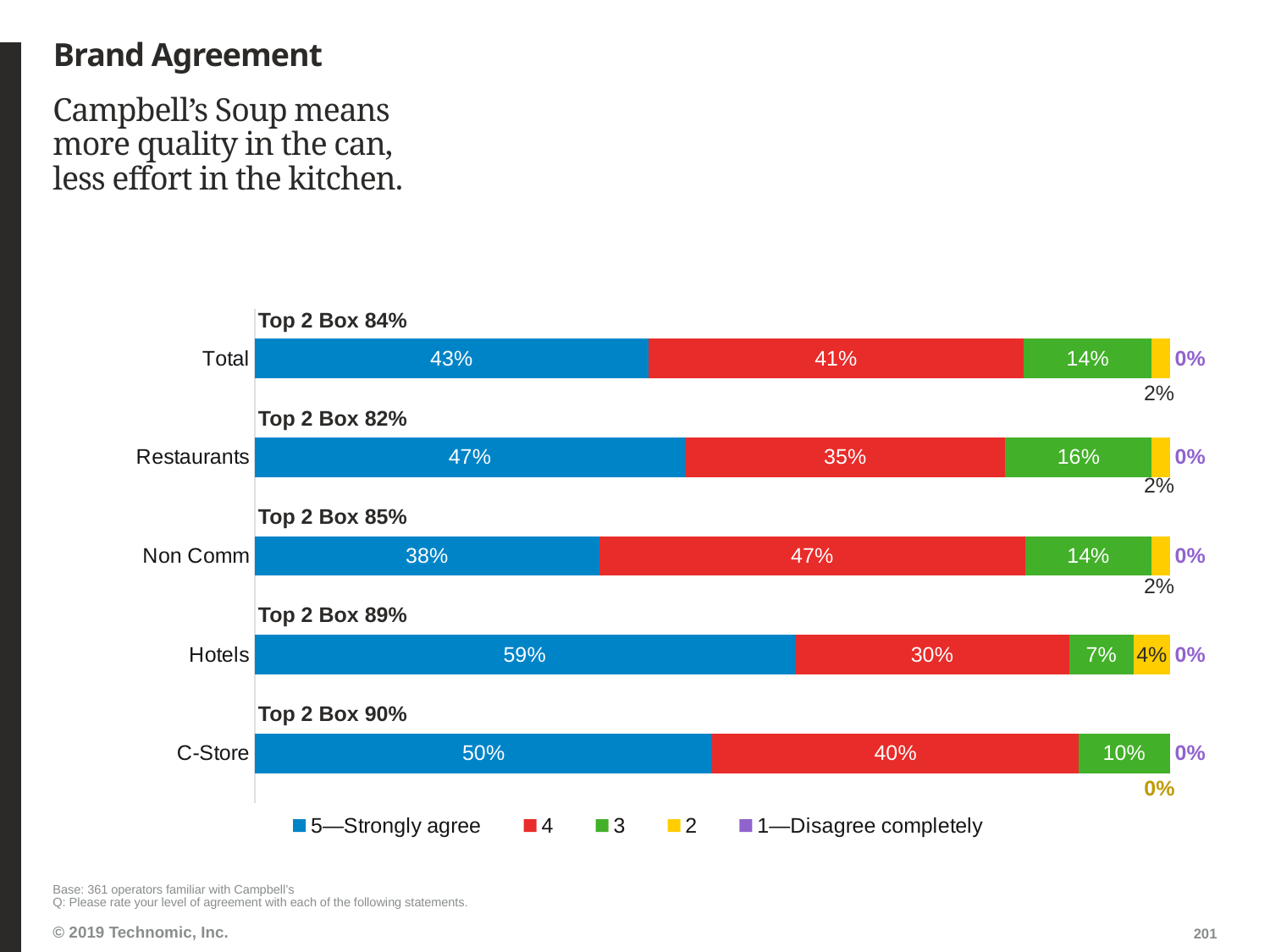
How many series does the legend list? 5 What is the difference between the "5—Strongly agree" values for Hotels and Total? 16% Which category has the highest "5—Strongly agree" value? Hotels What is the Top 2 Box value for C-Store? 90% What is the "5—Strongly agree" value for Hotels? 59% Which is larger, the "4" value for Total or the "4" value for Restaurants? Total How many categories are plotted on the chart? 5 Which category has the lowest "5—Strongly agree" value? Non Comm What kind of chart is shown on the slide? Stacked bar chart What is the "3" value for Restaurants? 16% What is the combined total of the "5—Strongly agree" and "4" segments for Restaurants? 82% What is the "4" value for Non Comm? 47%